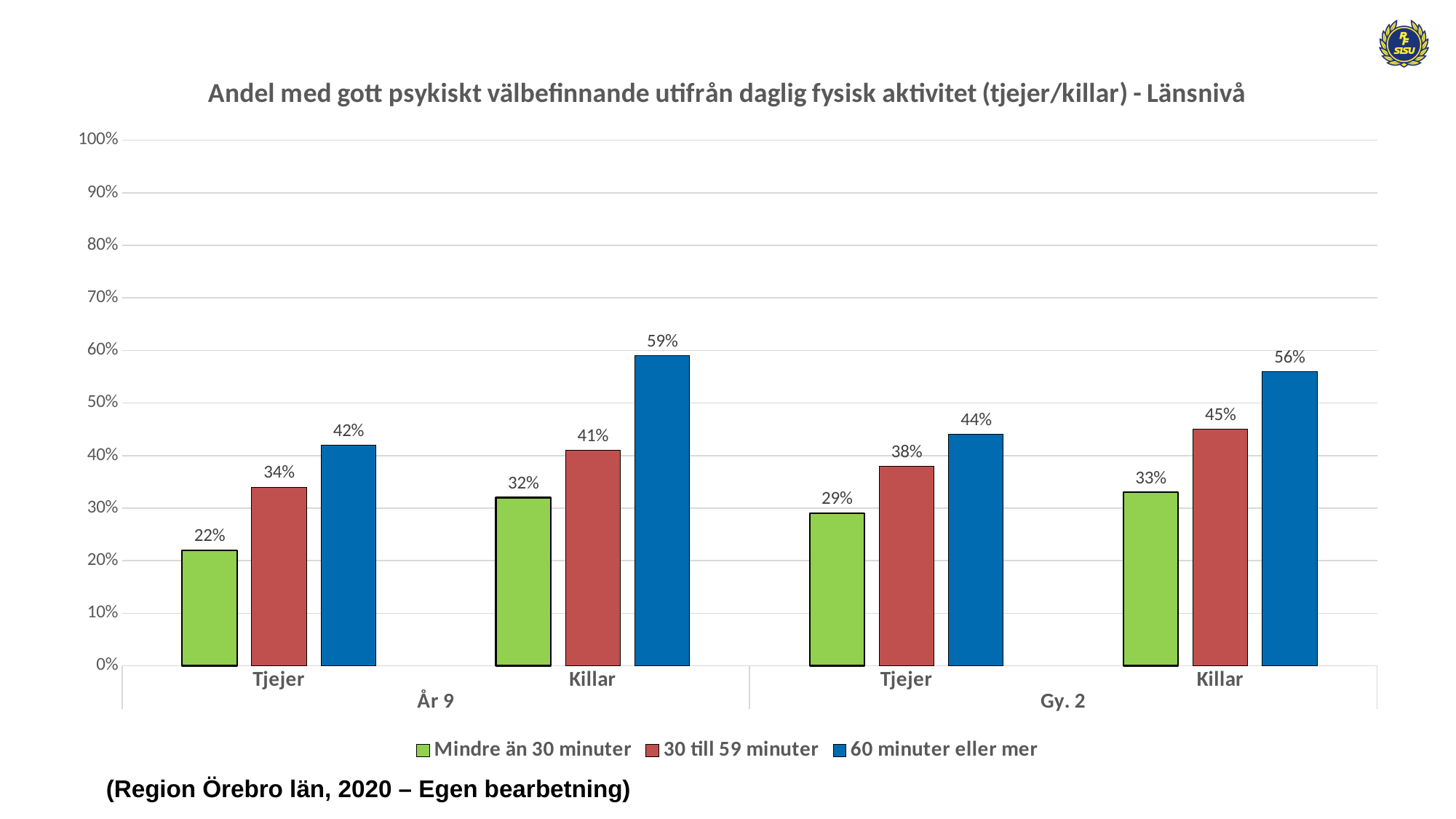
Which is larger: the "30 till 59 minuter" value for Tjejer in Gy. 2 or for Killar in År 9? Killar in År 9 What colour represents the "60 minuter eller mer" series? Blue What kind of chart is shown on the slide? Bar chart Which group has the lowest value for "Mindre än 30 minuter"? Tjejer, År 9 What is the difference between the "60 minuter eller mer" and "Mindre än 30 minuter" values for Tjejer in År 9? 20 percentage points How many series does the legend list? 3 Which group has the highest value for "60 minuter eller mer"? Killar, År 9 What is the value for "Mindre än 30 minuter" for Tjejer in Gy. 2? 29% What is the value for "30 till 59 minuter" for Killar in Gy. 2? 45% Within each group, do the values rise or fall from "Mindre än 30 minuter" to "60 minuter eller mer"? Rise Is the value for "60 minuter eller mer" for Killar in Gy. 2 greater or less than 50%? greater What is the value for "60 minuter eller mer" for Killar in År 9? 59%